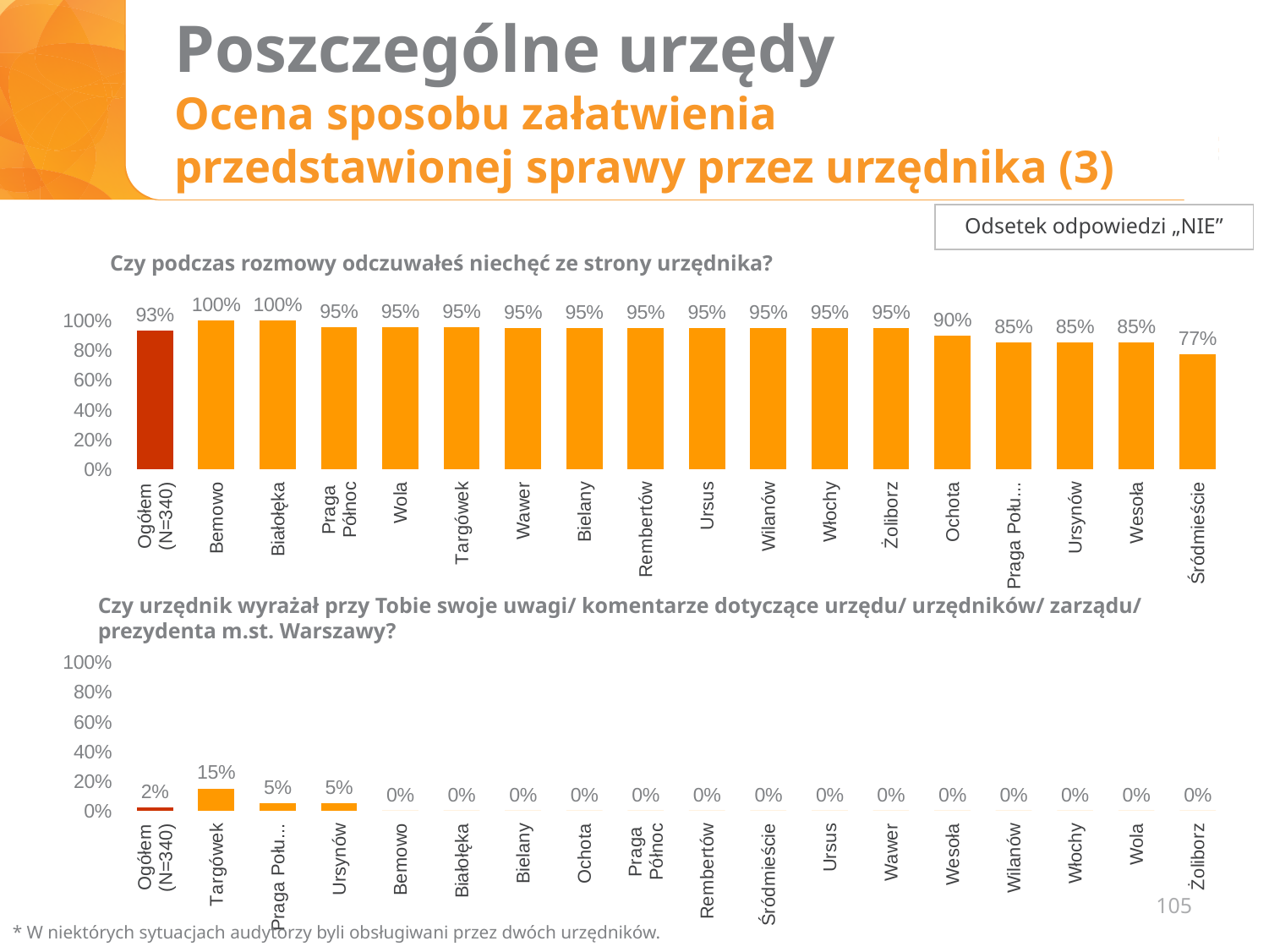
In the top chart, what is the value for Ochota? 90% In the top chart, what is the difference between the values for Bemowo and Śródmieście? 23% In the top chart, what is the value for Ogółem (N=340)? 93% In the bottom chart, which category has the highest value? Targówek In the top chart, what is the value for Śródmieście? 77% In the bottom chart, what is the value for Targówek? 15% In the top chart, which category has the lowest value? Śródmieście In the bottom chart, what is the value for Ogółem (N=340)? 2% In the top chart, which is larger, the value for Ochota or the value for Ursynów? Ochota In the bottom chart, what is the difference between the values for Targówek and Ursynów? 10% What type of chart is the top chart? Bar chart How many categories are shown on the x axis of the top chart? 18